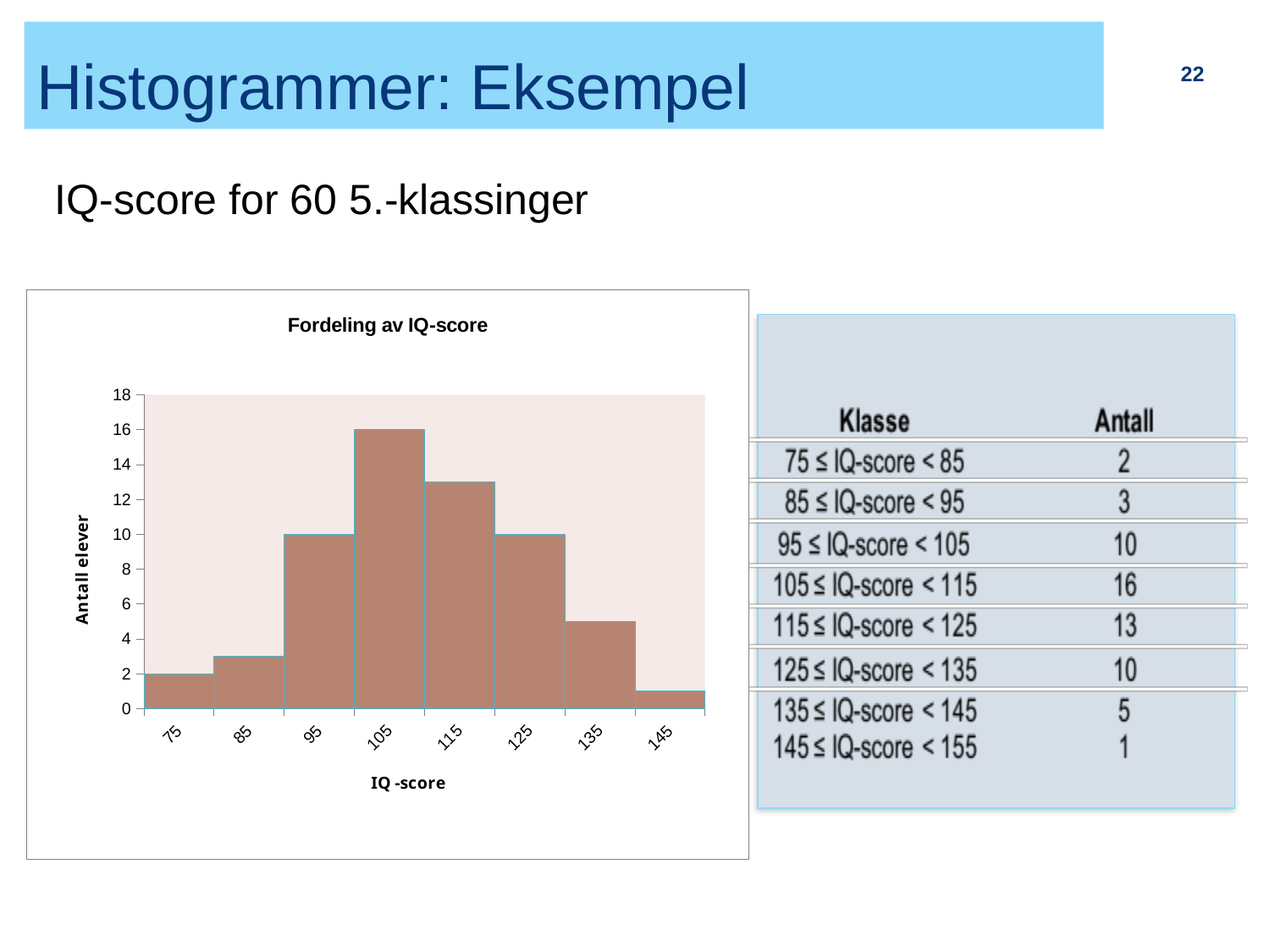
What is the value (Antall elever) for the bar at 95? 10 What type of chart is shown on the slide? bar chart (histogram) What is the label of the y axis? Antall elever What is the value (Antall elever) for the bar at 75? 2 What is the title of the chart? Fordeling av IQ-score Which bar is taller, the one at 95 or the one at 135? 95 What is the difference between the values for the bars at 105 and 115? 3 What is the value (Antall elever) for the bar at 105? 16 Which IQ-score class has the highest number of pupils? 105 Is the value for the bar at 115 greater or less than 12? greater How many bars does the chart have? 8 Which IQ-score class has the lowest number of pupils? 145